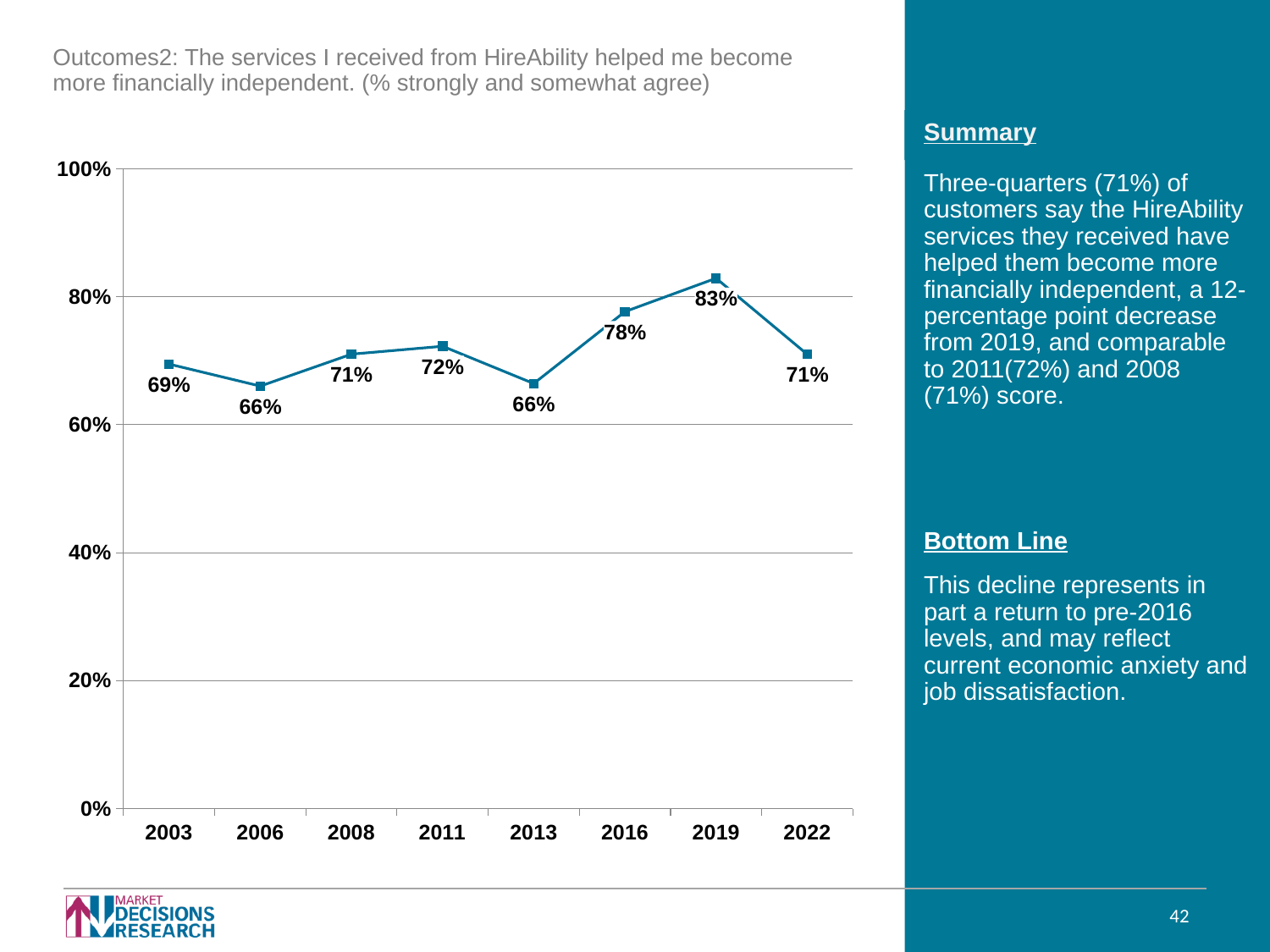
Do the values rise or fall from 2019 to 2022? fall What is the value for 2019? 83% How many years are plotted on the chart? 8 What is the difference between the 2019 value and the 2022 value? 12 percentage points What kind of chart is shown? line chart What is the value for 2022? 71% Which years share the lowest value? 2006 and 2013 Is the value for 2019 greater or less than 80%? greater Which year has the highest value? 2019 What is the difference between the 2016 value and the 2013 value? 12 percentage points Which is larger, the value for 2016 or the value for 2011? 2016 What is the value for 2003? 69%